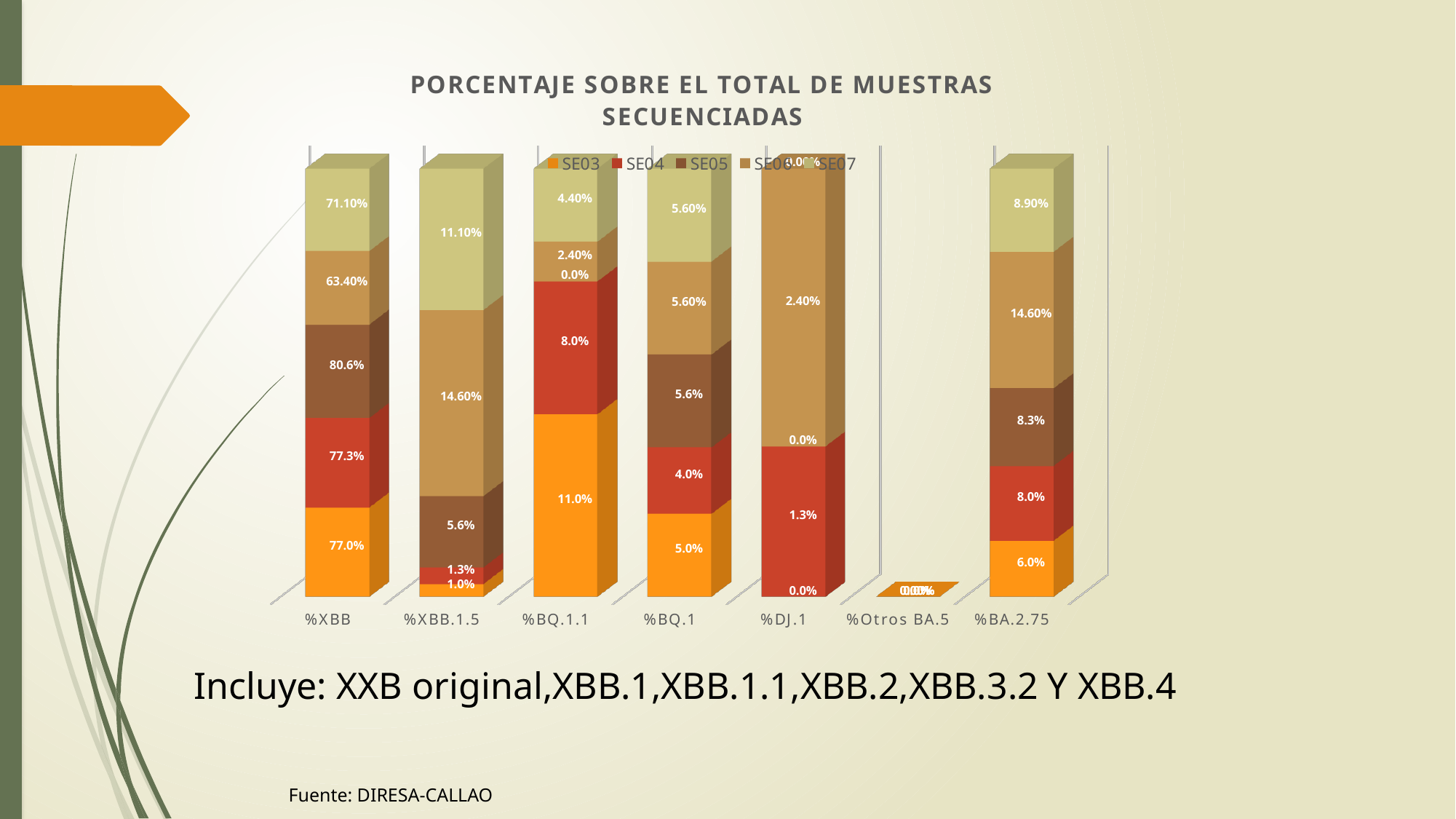
Which is larger, the SE06 value for %BA.2.75 or the SE06 value for %BQ.1? %BA.2.75 How many categories are shown on the x axis? 7 What is the difference between the SE03 value for %BQ.1.1 and the SE03 value for %BQ.1? 6.0% Which category has the highest SE05 value? %XBB What type of chart is shown on the slide? Stacked bar chart What is the SE04 value for %DJ.1? 1.3% What is the title of the chart? PORCENTAJE SOBRE EL TOTAL DE MUESTRAS SECUENCIADAS What is the SE07 value for %BA.2.75? 8.90% What is the SE03 value for %XBB? 77.0% What is the SE06 value for %XBB.1.5? 14.60% What is the SE04 value for %BQ.1.1? 8.0% How many series does the legend list? 5